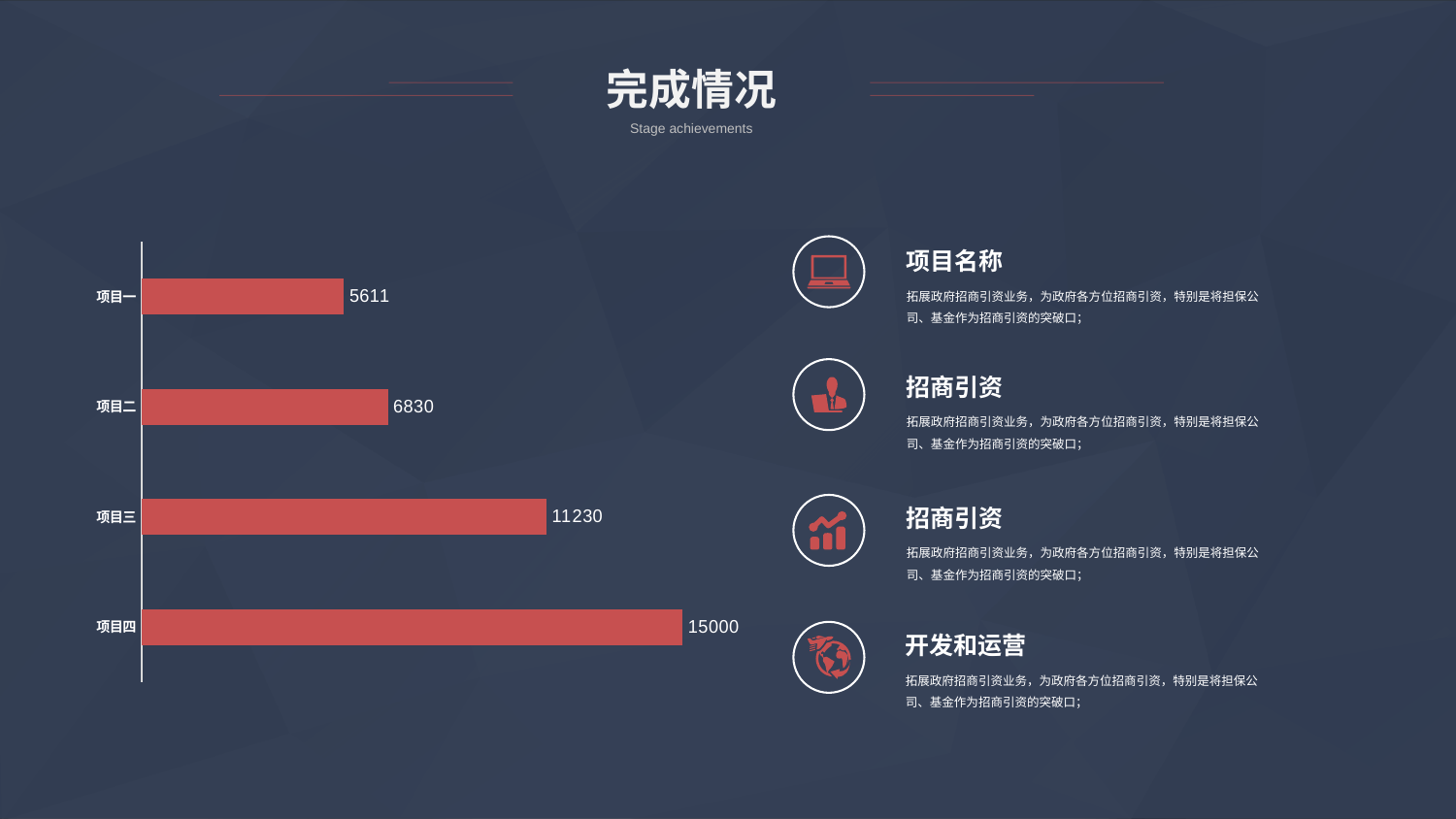
What is the difference between the values for 项目二 and 项目一? 1219 What is the difference between the values for 项目四 and 项目三? 3770 What is the value for 项目四? 15000 Which category has the highest value? 项目四 What is the value for 项目一? 5611 What colour are the bars in the chart? red What is the value for 项目二? 6830 Which is larger, the value for 项目二 or the value for 项目三? 项目三 Which category has the lowest value? 项目一 What kind of chart is shown on the slide? bar chart How many categories are shown in the chart? 4 What is the value for 项目三? 11230